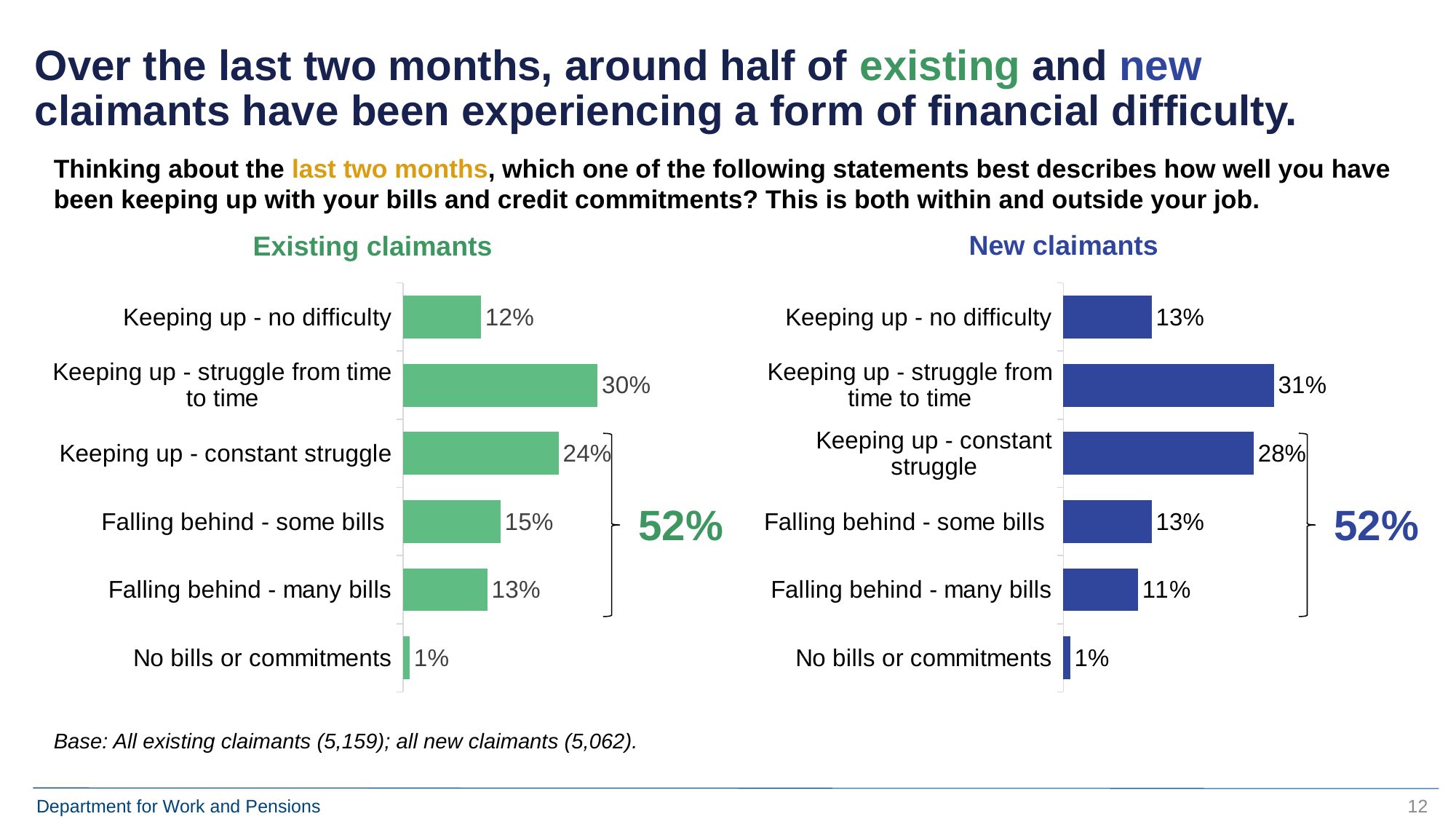
How many categories does the Existing claimants chart show? 6 In the New claimants chart, what is the difference between 'Keeping up - struggle from time to time' and 'Keeping up - no difficulty'? 18% In the Existing claimants chart, which category has the highest value? Keeping up - struggle from time to time What colour are the bars in the New claimants chart? Blue In the Existing claimants chart, what combined percentage is shown by the bracket covering 'Keeping up - constant struggle' through 'Falling behind - many bills'? 52% Which is larger: 'Falling behind - some bills' in the Existing claimants chart or 'Falling behind - some bills' in the New claimants chart? Existing claimants In the New claimants chart, what is the value for 'Keeping up - constant struggle'? 28% In the Existing claimants chart, what is the value for 'Keeping up - struggle from time to time'? 30% In the New claimants chart, which category has the lowest value? No bills or commitments In the New claimants chart, what is the value for 'Falling behind - many bills'? 11% What type of chart is the New claimants chart? Bar chart In the Existing claimants chart, what is the difference between 'Keeping up - constant struggle' and 'Falling behind - some bills'? 9%